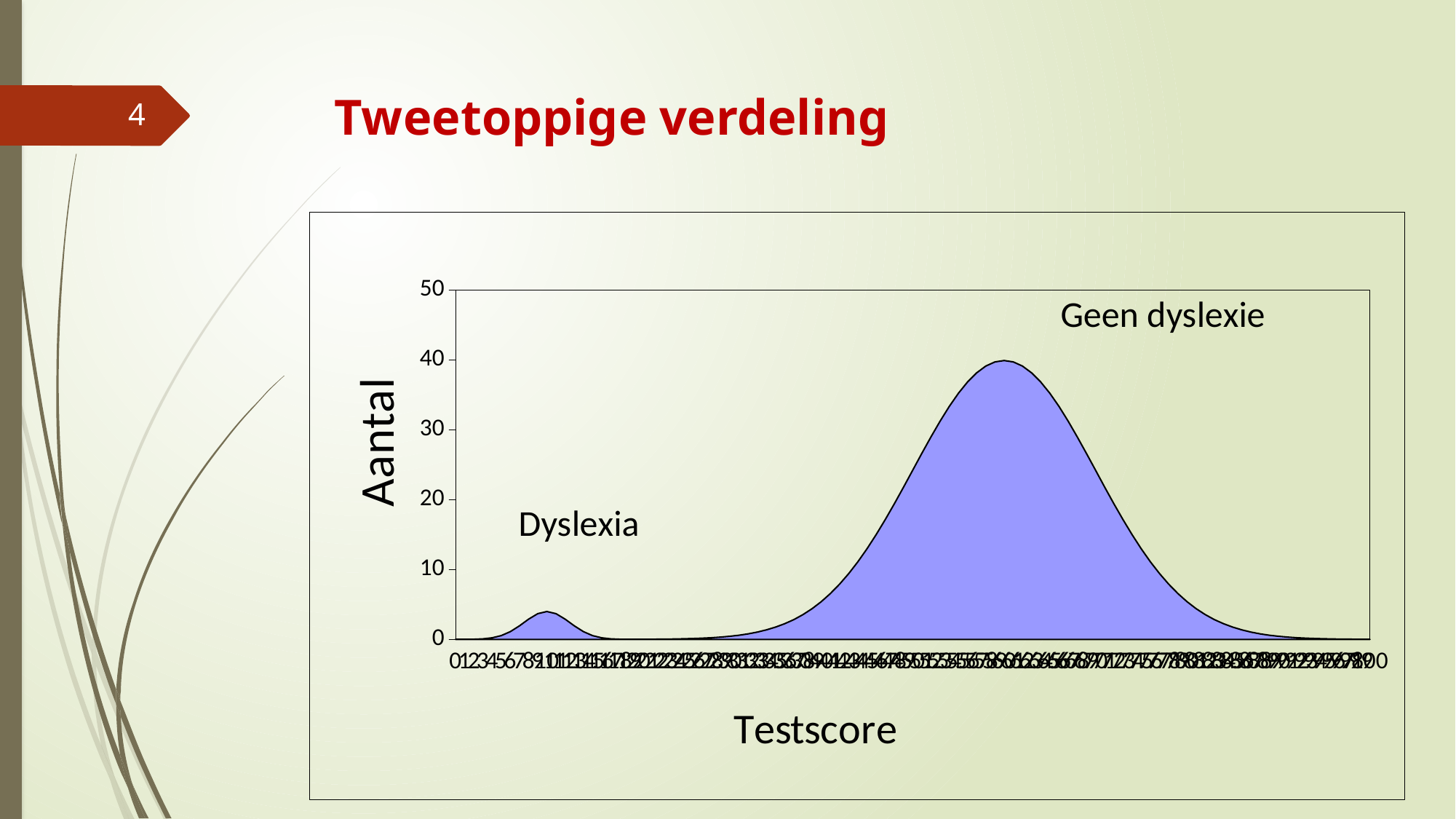
What is the label on the vertical axis of the chart? Aantal Which peak is higher, the one labelled Dyslexia or the one labelled Geen dyslexie? Geen dyslexie Is the peak value of the Geen dyslexie group greater or less than 30? greater What is the title of the slide containing the chart? Tweetoppige verdeling Is the peak value of the Dyslexia group greater or less than 0? greater What is the highest tick value shown on the vertical axis? 50 Is the peak value of the Geen dyslexie group greater or less than 50? less What kind of chart is shown on the slide? area chart Which labelled group has the lowest peak in the chart? Dyslexia How many peaks does the distribution in the chart have? 2